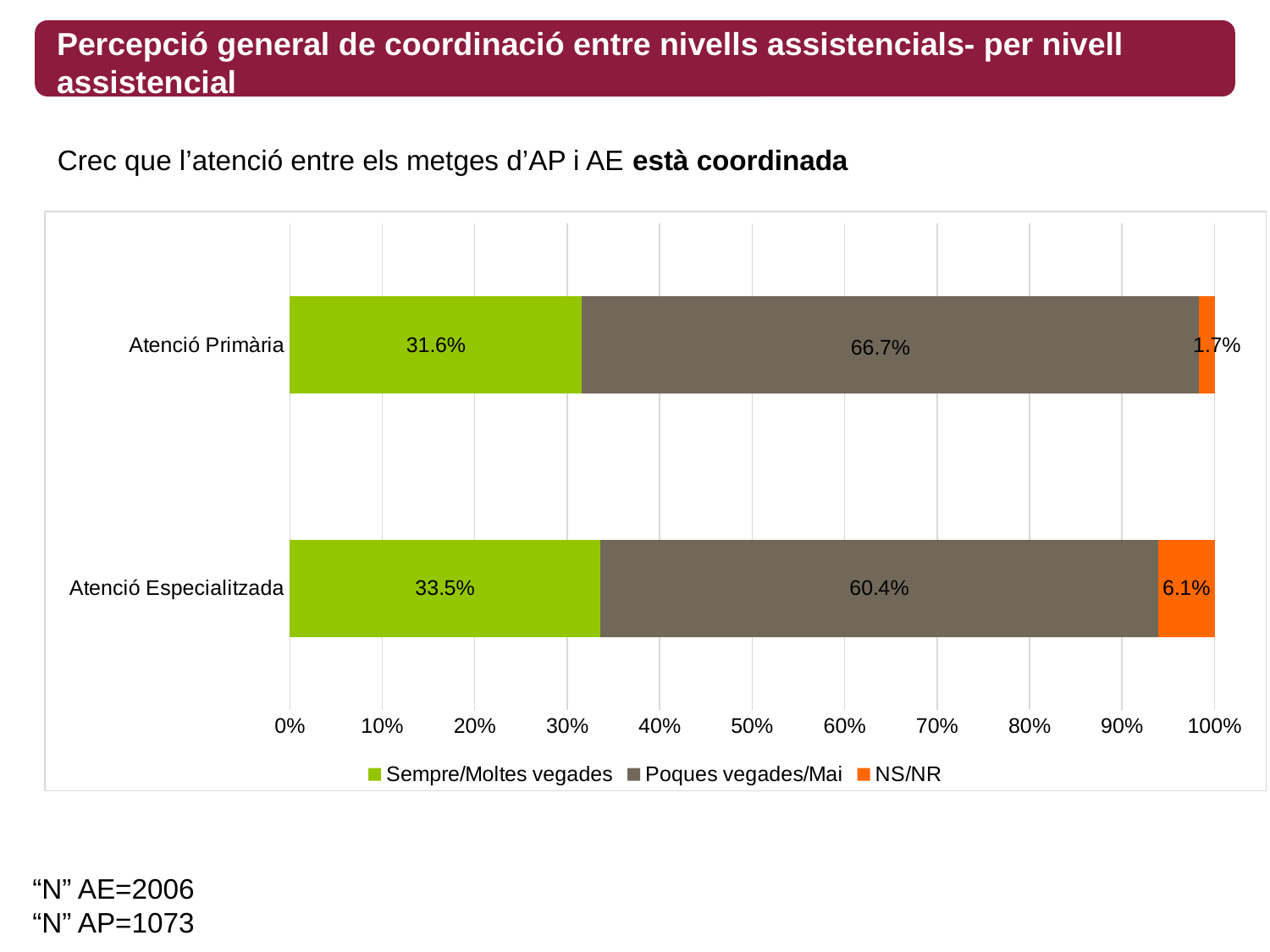
What is the difference between the Poques vegades/Mai values for Atenció Primària and Atenció Especialitzada? 6.3% Which category has the higher value for Poques vegades/Mai? Atenció Primària How many categories are shown on the chart? 2 Is the NS/NR value larger for Atenció Primària or Atenció Especialitzada? Atenció Especialitzada How many series does the legend list? 3 Which colour represents the NS/NR series in the legend? Orange Which category has the lower value for Sempre/Moltes vegades? Atenció Primària What kind of chart is shown on the slide? Stacked bar chart What is the NS/NR value for Atenció Primària? 1.7% What is the value for Sempre/Moltes vegades for Atenció Primària? 31.6% What is the NS/NR value for Atenció Especialitzada? 6.1% What is the value for Poques vegades/Mai for Atenció Especialitzada? 60.4%